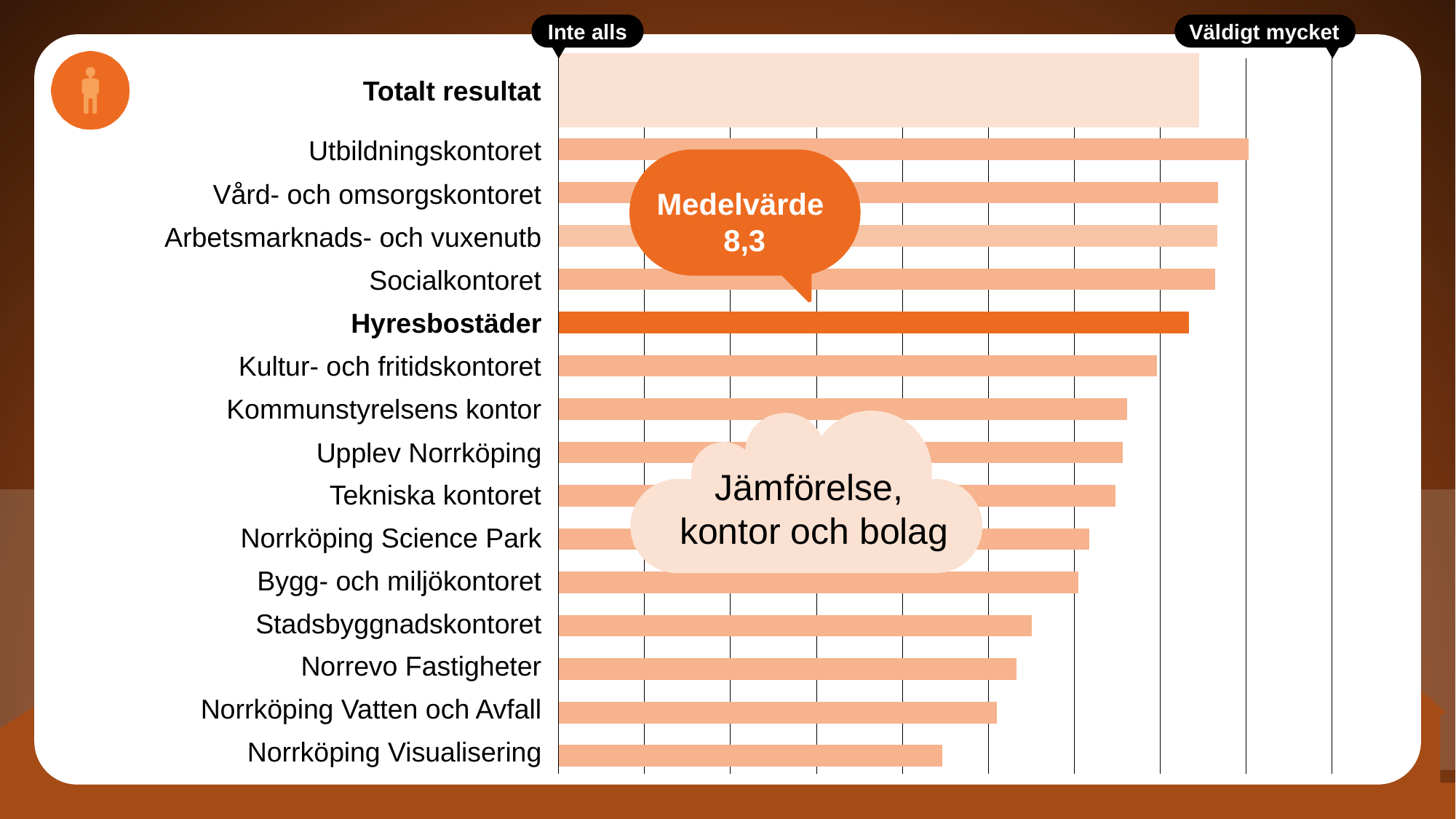
Do the bars get longer or shorter going down the list from Utbildningskontoret to Norrköping Visualisering? shorter Which has the longer bar, Norrevo Fastigheter or Norrköping Vatten och Avfall? Norrevo Fastigheter Which office or company has the shortest bar in the chart? Norrköping Visualisering Which has the longer bar, Utbildningskontoret or Norrköping Visualisering? Utbildningskontoret What mean value (Medelvärde) is shown in the speech bubble on the chart? 8,3 Which category's bar is highlighted in a darker orange than the others? Hyresbostäder What kind of chart is shown on the slide? bar chart How many offices and companies are listed in the chart, not counting 'Totalt resultat'? 15 Which office or company has the longest bar in the chart? Utbildningskontoret Which has the longer bar, Socialkontoret or Stadsbyggnadskontoret? Socialkontoret